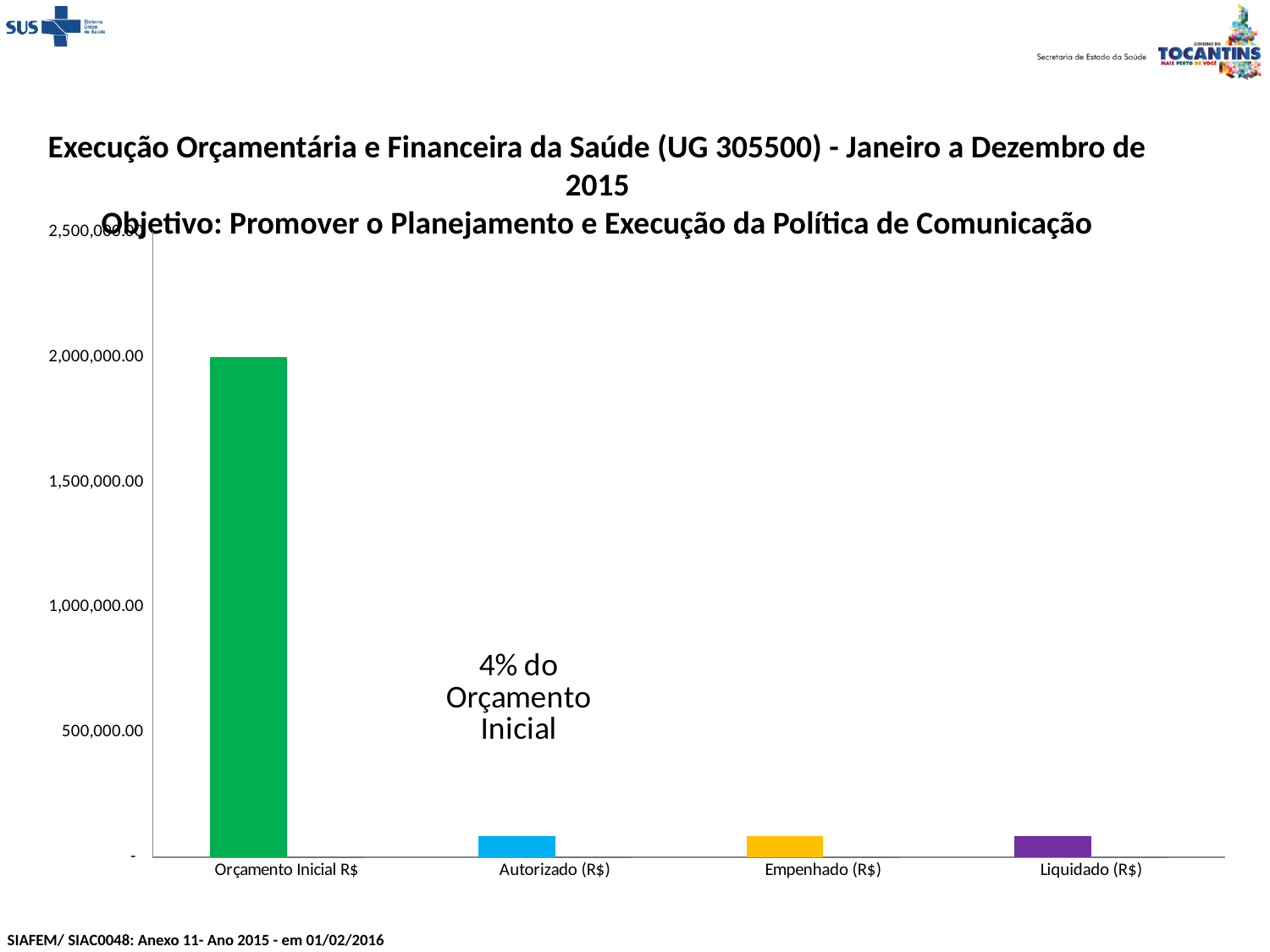
What kind of chart is shown on the slide? bar chart Is the value for Orçamento Inicial R$ greater or less than 1,500,000.00? greater What colour is the bar for Orçamento Inicial R$? green Is the value for Liquidado (R$) greater or less than 1,000,000.00? less How many categories are shown on the x axis of the chart? 4 Which is larger, the value for Empenhado (R$) or the value for Orçamento Inicial R$? Orçamento Inicial R$ Is the value for Empenhado (R$) greater or less than 500,000.00? less What does the text annotation placed above the Autorizado (R$) bar say? 4% do Orçamento Inicial Which is larger, the value for Orçamento Inicial R$ or the value for Autorizado (R$)? Orçamento Inicial R$ Which category has the highest value in the chart? Orçamento Inicial R$